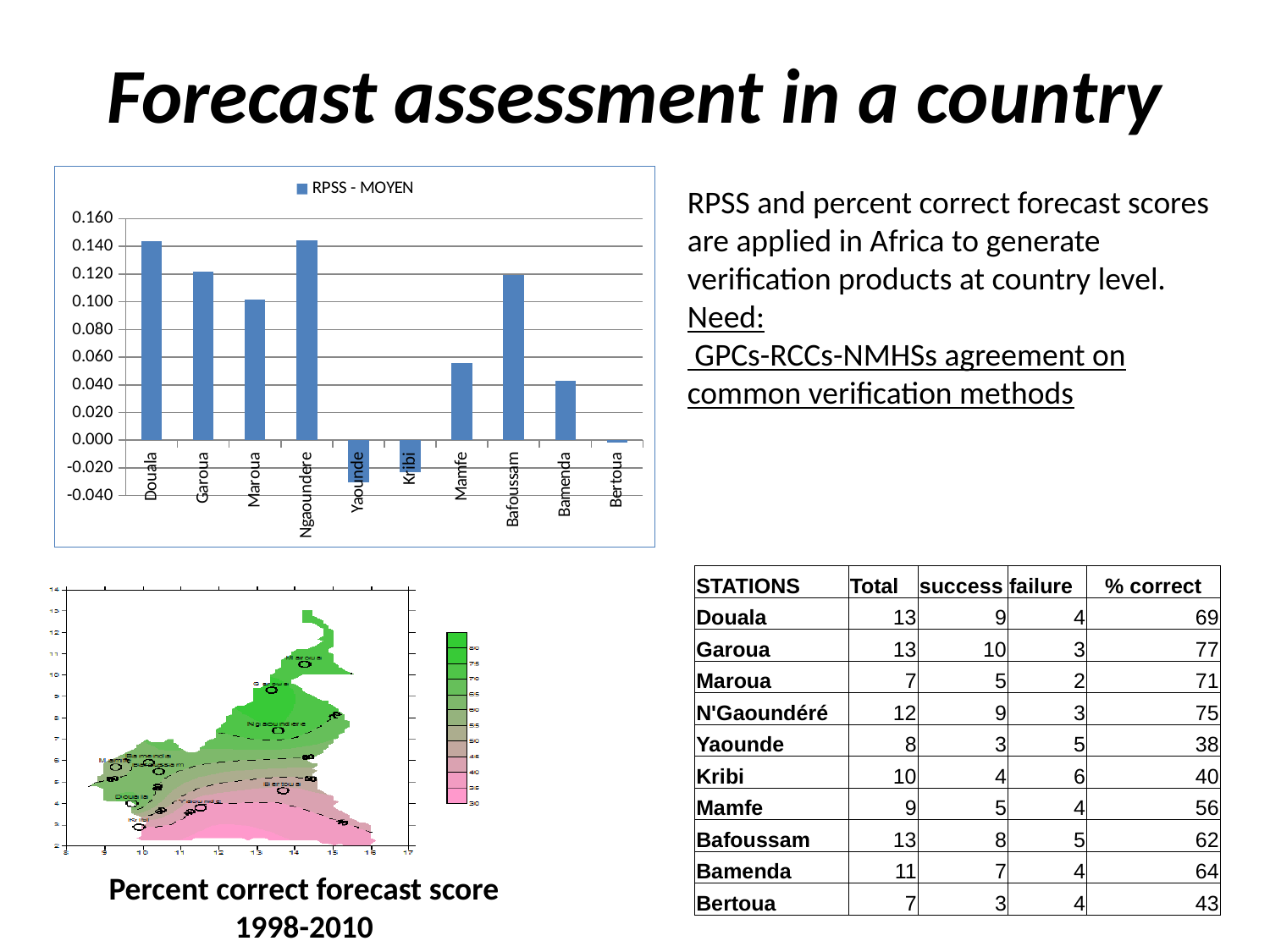
In the RPSS - MOYEN chart, which has the larger value, Garoua or Maroua? Garoua In the RPSS - MOYEN chart, is the value for Bafoussam greater or less than 0.100? greater In the RPSS - MOYEN chart, which has the larger value, Douala or Bafoussam? Douala In the RPSS - MOYEN chart, is the value for Yaounde greater or less than 0.000? less In the RPSS - MOYEN chart, is the value for Douala greater or less than 0.120? greater How many stations are shown on the x axis of the RPSS - MOYEN chart? 10 In the RPSS - MOYEN chart, which has the larger value, Mamfe or Bamenda? Mamfe What is the legend entry of the bar chart? RPSS - MOYEN How many series does the legend of the RPSS - MOYEN chart list? 1 What kind of chart is the RPSS - MOYEN chart? bar chart